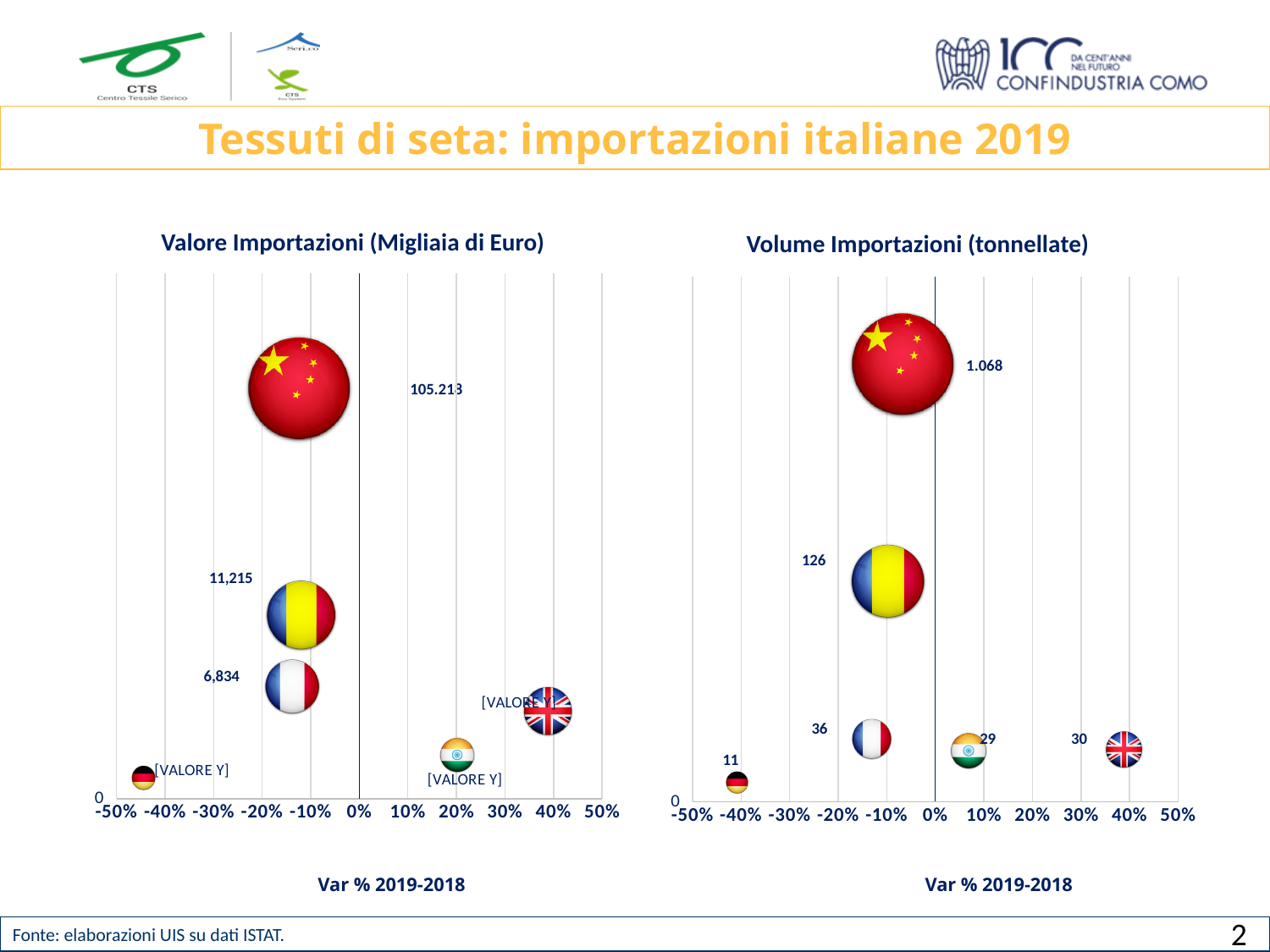
What kind of chart is the 'Volume Importazioni (tonnellate)' chart? Bubble chart On the 'Volume Importazioni (tonnellate)' chart, what value is labelled next to the bubble with the Romanian flag? 126 On the 'Volume Importazioni (tonnellate)' chart, what value is labelled next to the bubble with the German flag? 11 On the 'Valore Importazioni (Migliaia di Euro)' chart, what value is labelled next to the bubble with the Chinese flag? 105.213 On the 'Volume Importazioni (tonnellate)' chart, which labelled value is larger: the UK flag bubble or the Indian flag bubble? UK (30) On the 'Volume Importazioni (tonnellate)' chart, is the Var % 2019-2018 for the German flag bubble greater or less than -30%? less On the 'Volume Importazioni (tonnellate)' chart, what is the difference between the labelled values for the Romanian flag bubble and the French flag bubble? 90 On the 'Volume Importazioni (tonnellate)' chart, which country's bubble has the lowest labelled volume? Germany (11) How many bubbles are plotted on the 'Valore Importazioni (Migliaia di Euro)' chart? 6 On the 'Valore Importazioni (Migliaia di Euro)' chart, what value is labelled next to the bubble with the Romanian flag? 11,215 On the 'Volume Importazioni (tonnellate)' chart, what value is labelled next to the bubble with the Chinese flag? 1.068 On the 'Valore Importazioni (Migliaia di Euro)' chart, what value is labelled next to the bubble with the French flag? 6,834